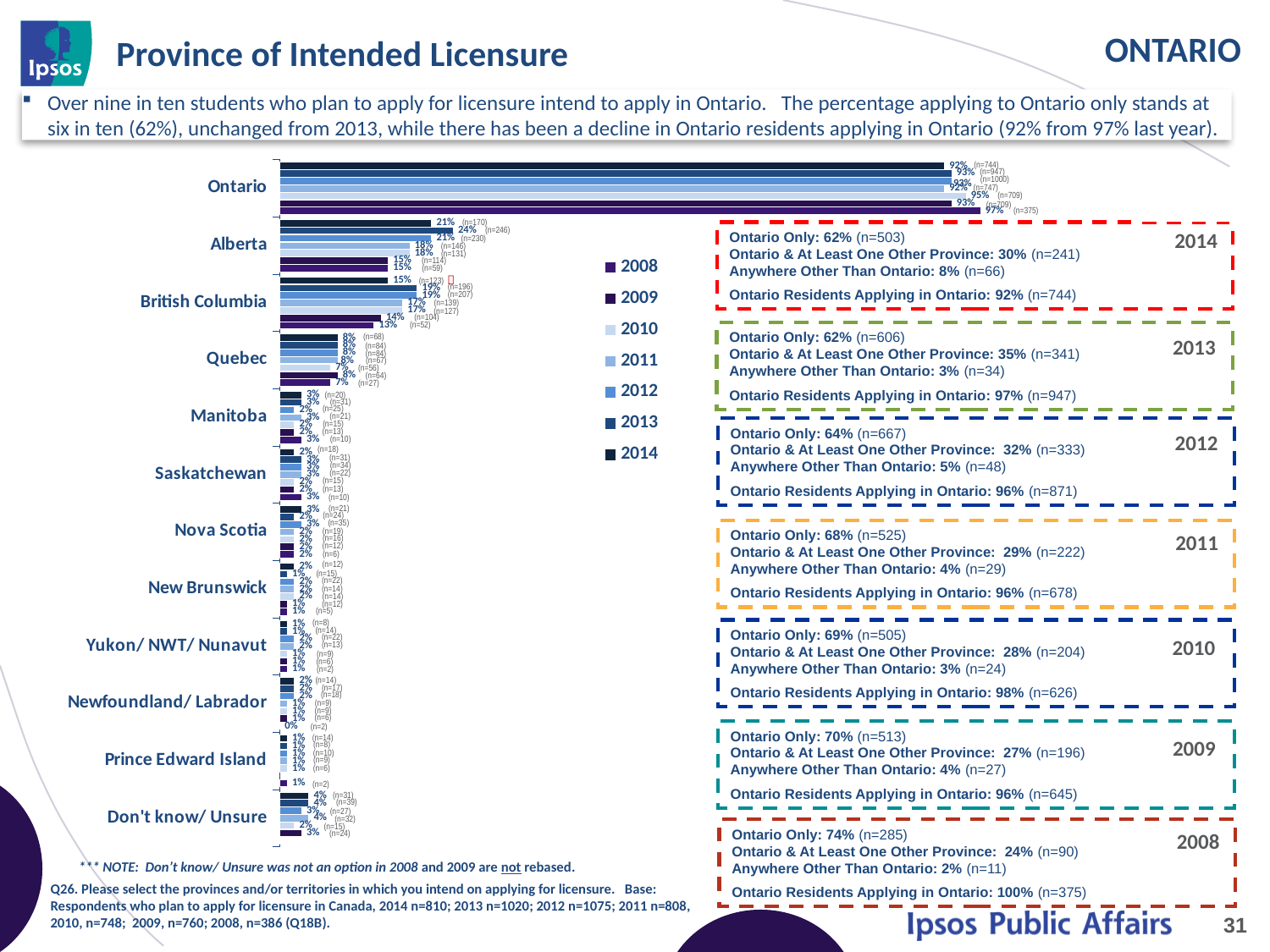
What is the 2013 value for Alberta in the chart? 24% What is the 2008 value for Ontario in the chart? 97% What kind of chart is shown on the slide? Bar chart How many categories are listed on the vertical axis of the chart? 12 What is the 2014 value for Quebec in the chart? 8% By how many percentage points did the Ontario value fall from 2008 to 2014? 5 percentage points In 2014, which is larger: the value for Alberta or the value for Quebec? Alberta Which category has the longest bars in the chart? Ontario Which years are listed in the chart legend? 2008, 2009, 2010, 2011, 2012, 2013, 2014 How many series does the chart legend list? 7 What is the 2014 value for Alberta in the chart? 21% What is the 2014 value for Ontario in the chart? 92%